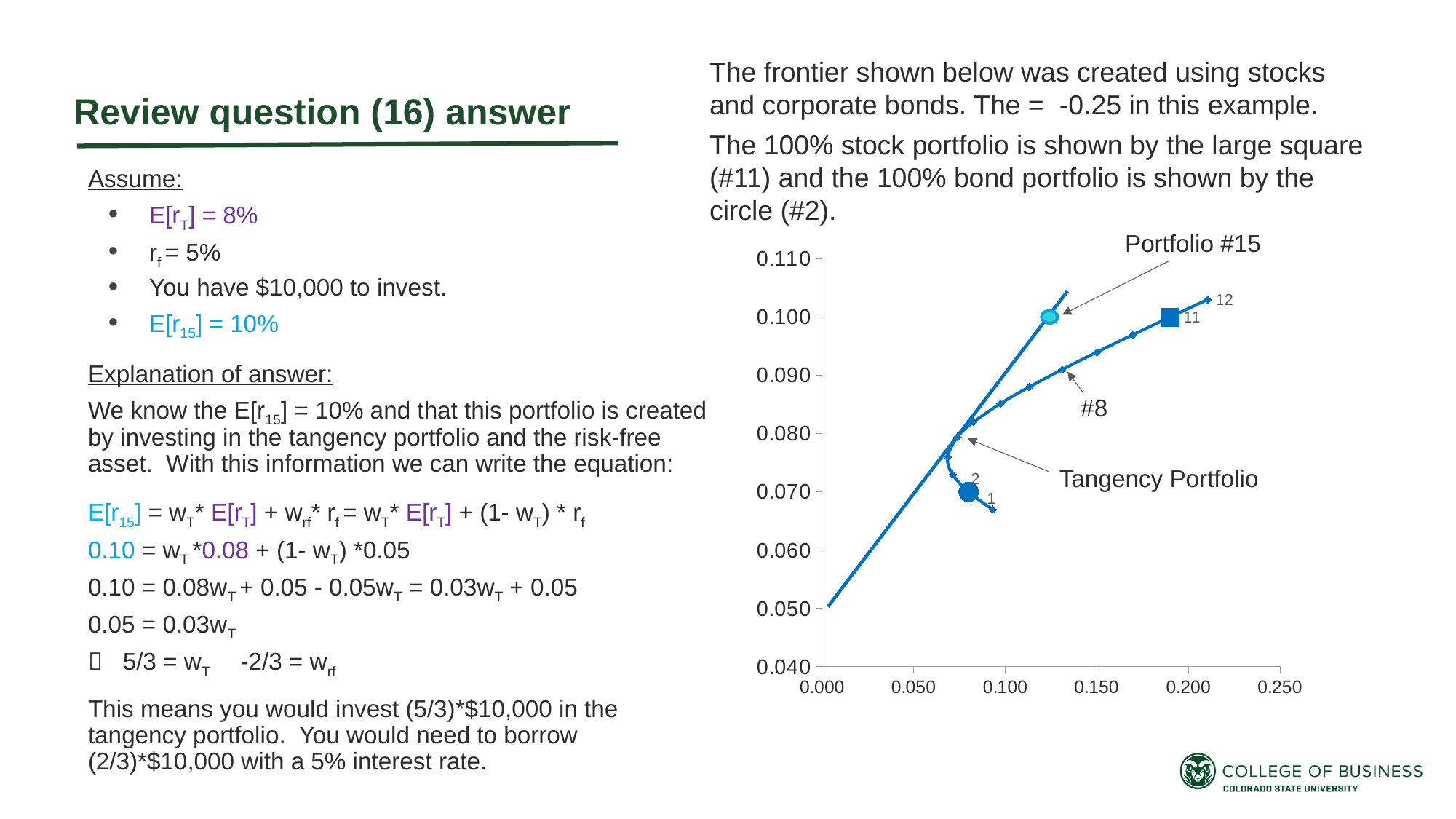
Is the y-axis value of point 12 greater or less than 0.100? greater Which labeled point on the chart has the highest y-axis value? 12 Which labeled point on the chart has the lowest y-axis value? 1 Is the x-axis value of the Tangency Portfolio greater or less than 0.100? less At what y-axis value does the straight line intersect the vertical axis (x = 0.000)? 0.050 Is the x-axis value of portfolio #8 greater or less than 0.150? less What kind of chart is shown on the slide? scatter chart What is the y-axis value of the large square labeled 11 (the 100% stock portfolio)? 0.100 What is the expected return (y-axis value) of Portfolio #15 on the chart? 0.100 Which point has the higher y-axis value, point 11 or point 12? 12 What is the y-axis value of the circle labeled 2 (the 100% bond portfolio)? 0.070